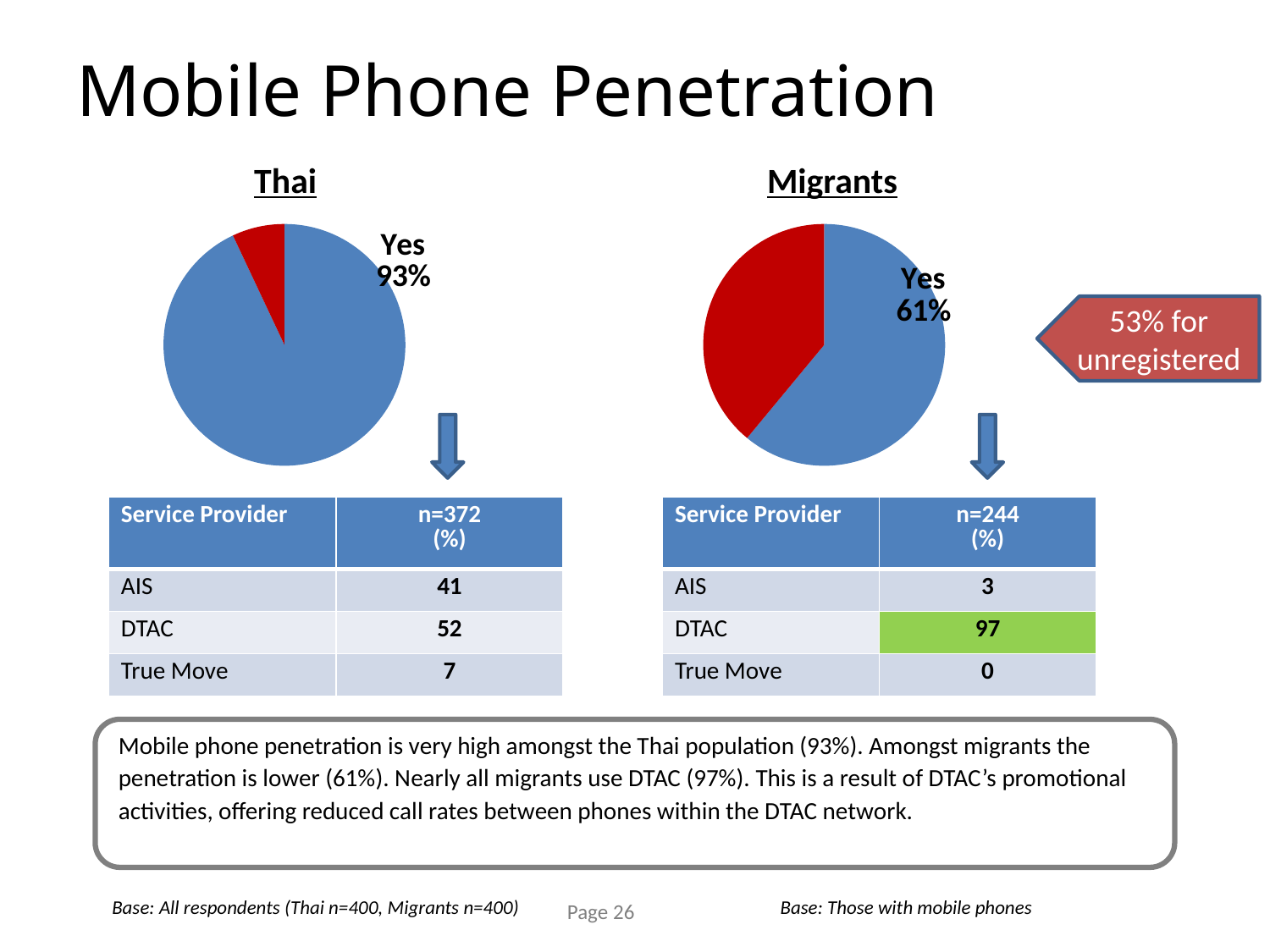
In the Thai pie chart, what share of respondents answered Yes? 93% What is the title above the left pie chart? Thai Which pie chart shows the larger Yes share, Thai or Migrants? Thai What colour is the Yes slice in both pie charts? Blue What kind of chart is used to show mobile phone penetration for Thai and Migrants? Pie chart In the Migrants pie chart, what share of respondents answered Yes? 61% How many slices does the Migrants pie chart have? 2 In the Thai pie chart, is the red slice larger or smaller than the Yes slice? smaller What is the difference between the Yes share in the Thai pie chart and the Yes share in the Migrants pie chart? 32 percentage points How many slices does the Thai pie chart have? 2 In the Migrants pie chart, is the Yes share greater or less than 50%? greater In the Migrants pie chart, which slice is the largest? Yes